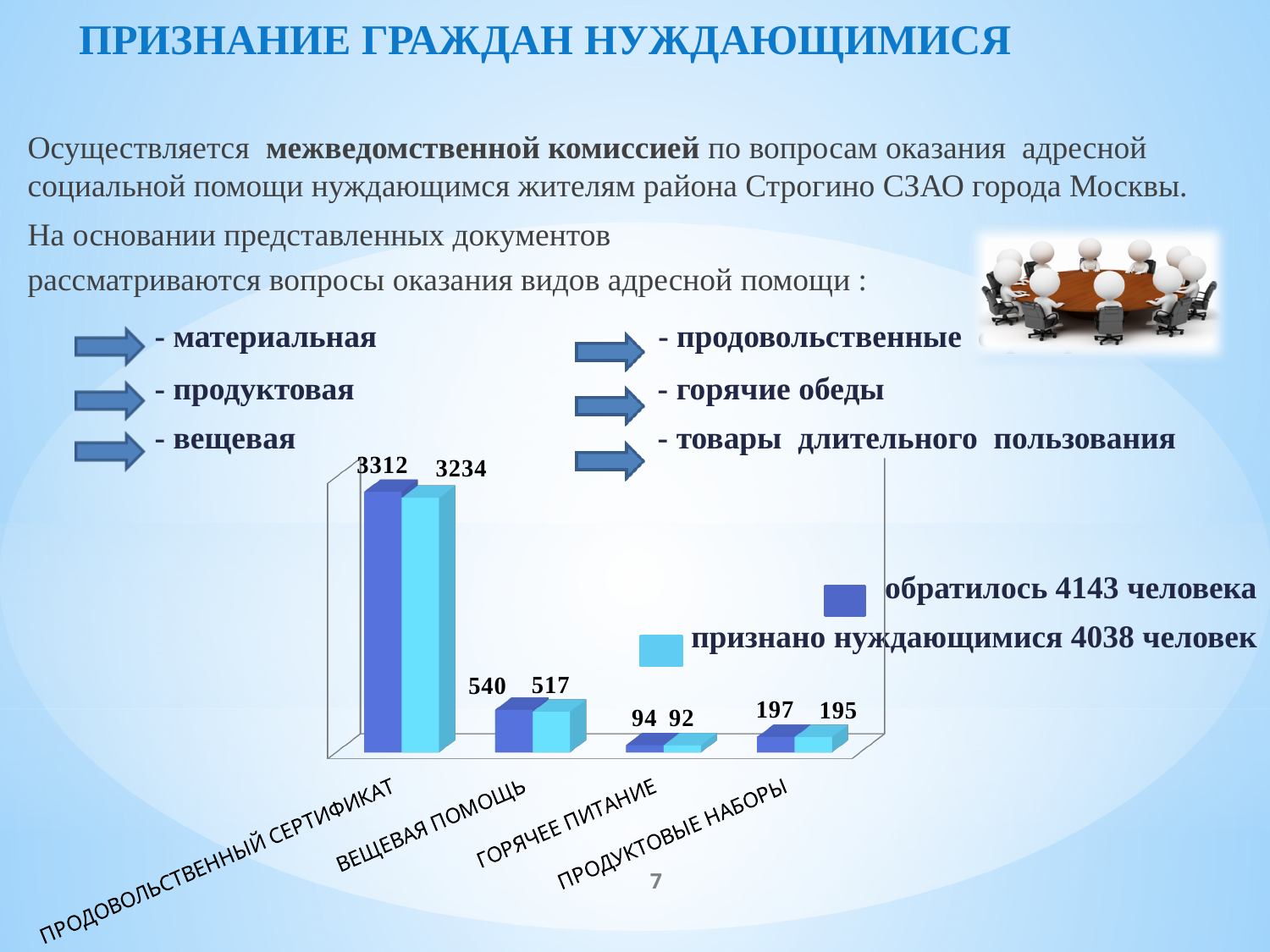
What kind of chart is shown on the slide? Bar chart How many series does the chart's legend list? 2 What value is shown for ВЕЩЕВАЯ ПОМОЩЬ in the признано нуждающимися series? 517 Which category has the highest value in the обратилось series? ПРОДОВОЛЬСТВЕННЫЙ СЕРТИФИКАТ What value is shown for ПРОДОВОЛЬСТВЕННЫЙ СЕРТИФИКАТ in the обратилось series? 3312 What value is shown for ГОРЯЧЕЕ ПИТАНИЕ in the обратилось series? 94 How many categories are shown on the x axis of the chart? 4 Which category has the lowest value in the признано нуждающимися series? ГОРЯЧЕЕ ПИТАНИЕ Which is larger: the обратилось value for ПРОДУКТОВЫЕ НАБОРЫ or for ГОРЯЧЕЕ ПИТАНИЕ? ПРОДУКТОВЫЕ НАБОРЫ What value is shown for ПРОДУКТОВЫЕ НАБОРЫ in the признано нуждающимися series? 195 What is the difference between the обратилось and признано нуждающимися values for ПРОДОВОЛЬСТВЕННЫЙ СЕРТИФИКАТ? 78 What is the difference between the обратилось values for ВЕЩЕВАЯ ПОМОЩЬ and ПРОДУКТОВЫЕ НАБОРЫ? 343